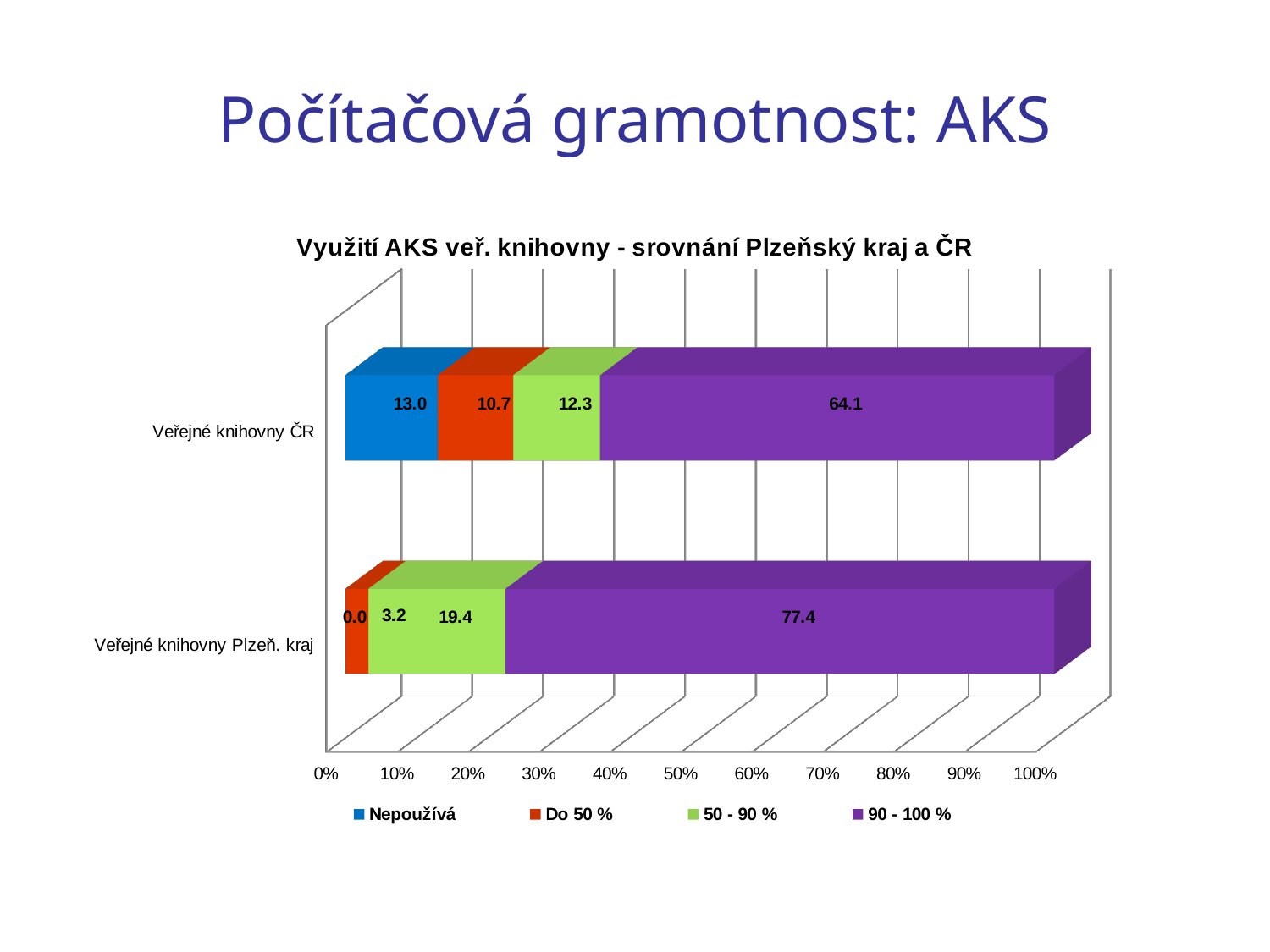
Which category has the higher value for the "90 - 100 %" series? Veřejné knihovny Plzeň. kraj How many categories are shown on the chart? 2 What is the value of the "50 - 90 %" series for Veřejné knihovny Plzeň. kraj? 19.4 What kind of chart is shown on the slide? Stacked bar chart What is the difference between the "50 - 90 %" values for Veřejné knihovny Plzeň. kraj and Veřejné knihovny ČR? 7.1 What is the value of the "Nepoužívá" series for Veřejné knihovny ČR? 13.0 What is the value of the "90 - 100 %" series for Veřejné knihovny ČR? 64.1 What is the value of the "90 - 100 %" series for Veřejné knihovny Plzeň. kraj? 77.4 How many series does the legend list? 4 Which series has the lowest value for Veřejné knihovny Plzeň. kraj? Nepoužívá What is the value of the "Do 50 %" series for Veřejné knihovny Plzeň. kraj? 3.2 What is the difference between the "90 - 100 %" values for Veřejné knihovny Plzeň. kraj and Veřejné knihovny ČR? 13.3